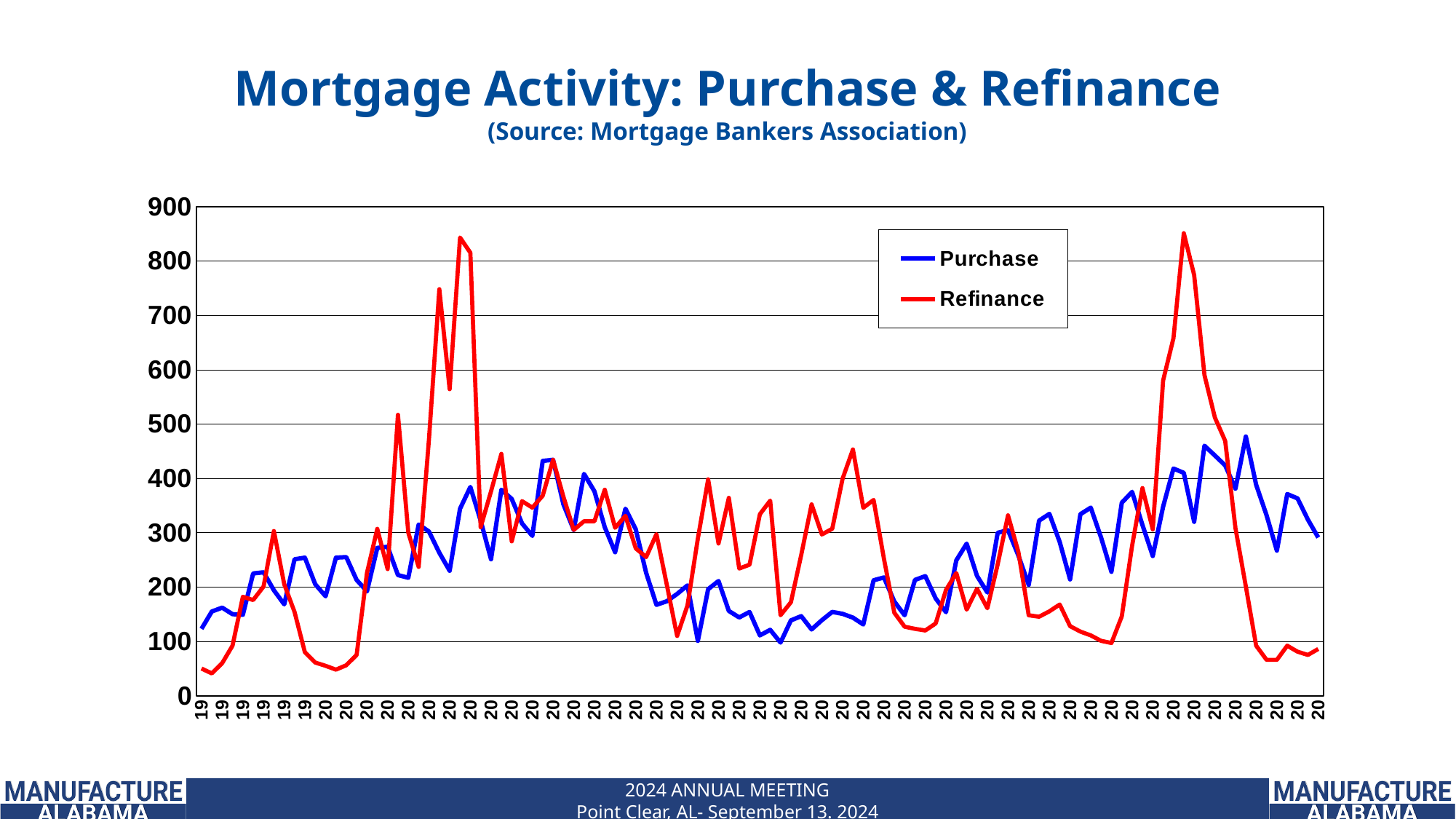
What kind of chart is shown on the slide? line chart Is the lowest value reached by the Purchase line greater or less than 200? less What is the highest value shown on the vertical axis? 900 Is the value of the Purchase line at the far right end of the chart greater or less than 200? greater At the far right end of the chart, which line is higher, Purchase or Refinance? Purchase Is the lowest value reached by the Refinance line greater or less than 100? less Which colour is used for the Refinance series? red How many series does the legend list? 2 Which series reaches the highest value anywhere on the chart, Purchase or Refinance? Refinance